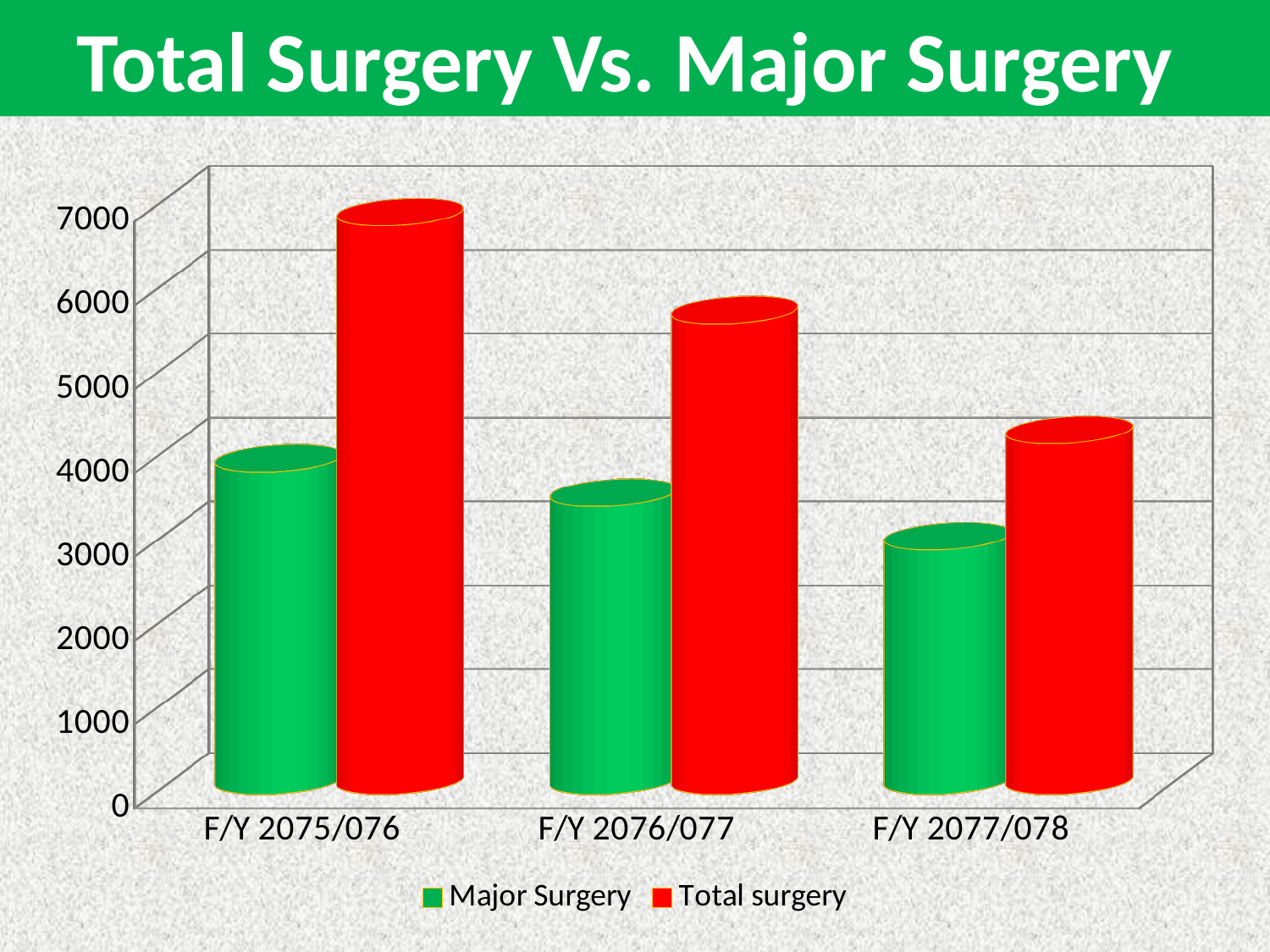
Which fiscal year has the lowest Total surgery value? F/Y 2077/078 Is the Major Surgery value for F/Y 2076/077 greater or less than 4000? less Which fiscal year has the lowest Major Surgery value? F/Y 2077/078 How many fiscal years are shown on the x axis? 3 Which fiscal year has the highest Total surgery value? F/Y 2075/076 How many series does the legend list? 2 Is the Total surgery value for F/Y 2075/076 greater or less than 6000? greater In F/Y 2076/077, which is larger: Major Surgery or Total surgery? Total surgery Is the Total surgery value for F/Y 2077/078 greater or less than 5000? less What kind of chart is shown on the slide? bar chart Do the Total surgery values rise or fall from F/Y 2075/076 to F/Y 2077/078? fall What colour represents Major Surgery in the chart? green